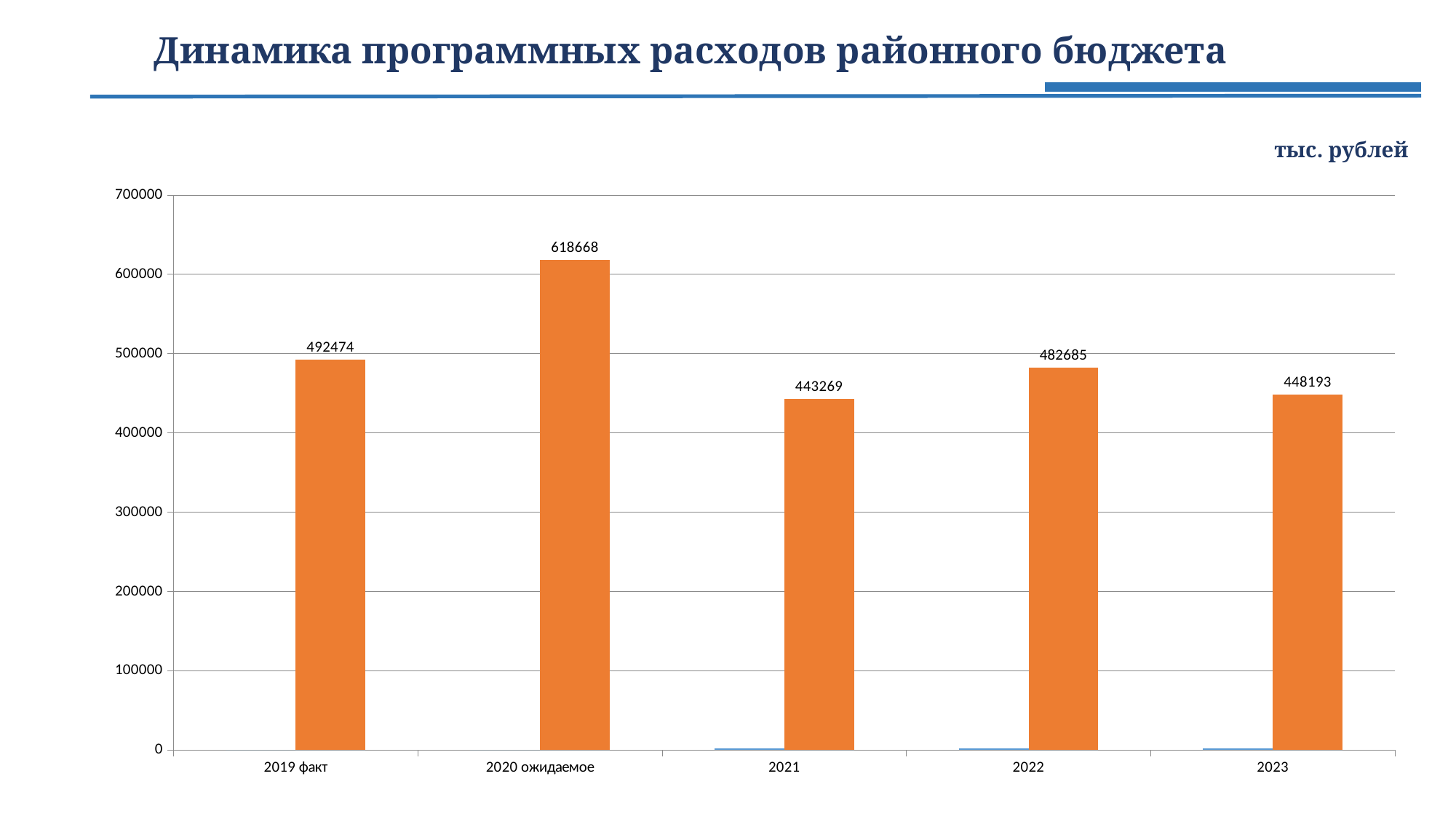
What is the value for 2023? 448193 Which category has the highest value? 2020 ожидаемое Is the value for 2021 greater or less than 500000? less Which is larger, the value for 2022 or the value for 2023? 2022 What is the difference between the values for 2023 and 2021? 4924 What is the difference between the values for 2020 ожидаемое and 2019 факт? 126194 Which category has the lowest value? 2021 What is the value for 2019 факт? 492474 How many categories are shown on the x axis? 5 What unit is stated above the chart? тыс. рублей What kind of chart is shown on the slide? bar chart What is the value for 2020 ожидаемое? 618668